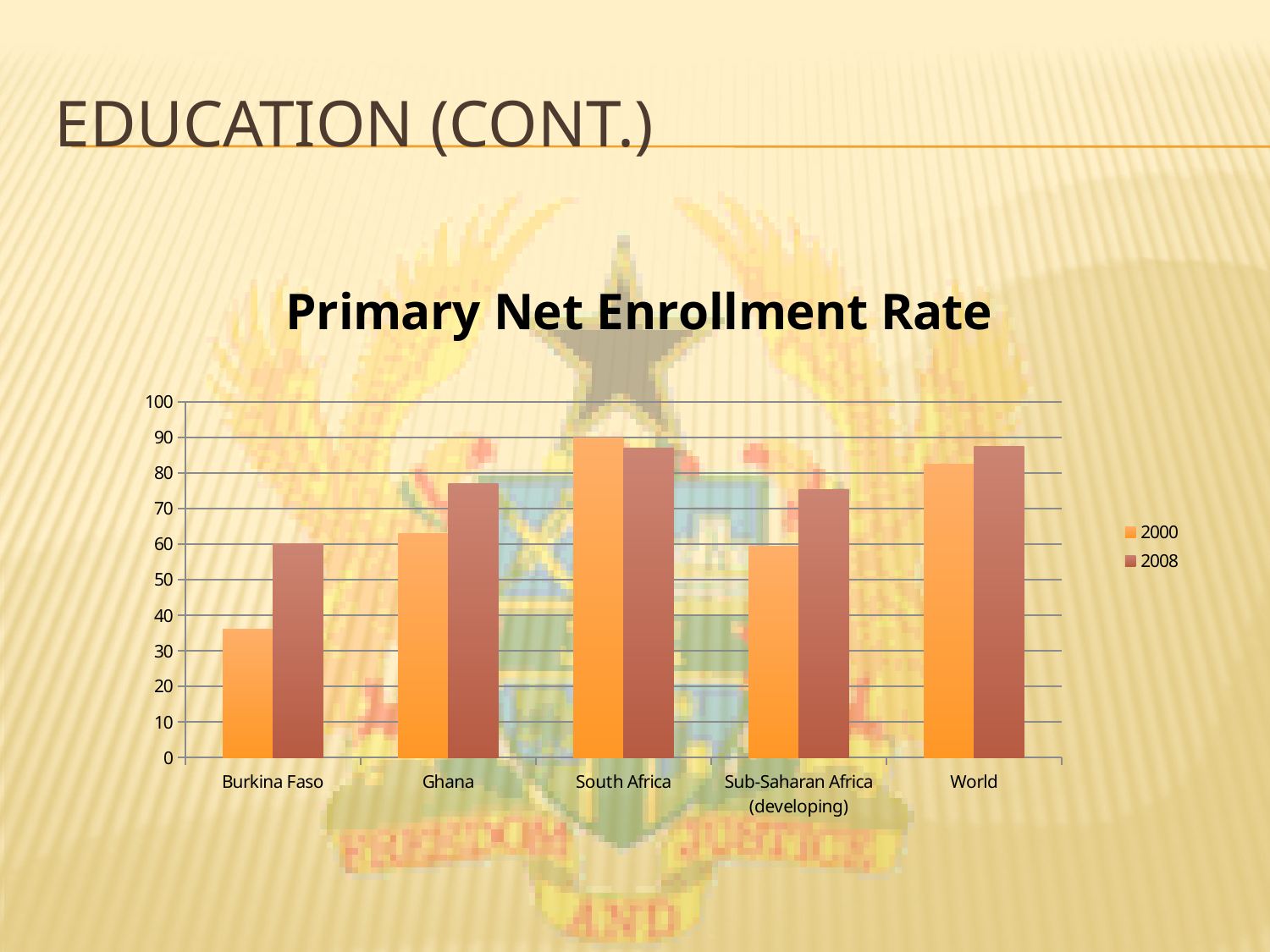
How many series does the legend list? 2 Is the 2000 value for South Africa greater or less than 80? greater Which category has the lowest value for 2008? Burkina Faso Is the 2008 value for Ghana greater or less than 70? greater How many categories are shown on the x axis? 5 What is the title of the chart? Primary Net Enrollment Rate Which category has the highest value for 2000? South Africa For Ghana, which is larger: the 2000 value or the 2008 value? 2008 Which category has the lowest value for 2000? Burkina Faso Is the 2000 value for Burkina Faso greater or less than 40? less For Burkina Faso, which is larger: the 2000 value or the 2008 value? 2008 What kind of chart is shown on the slide? bar chart